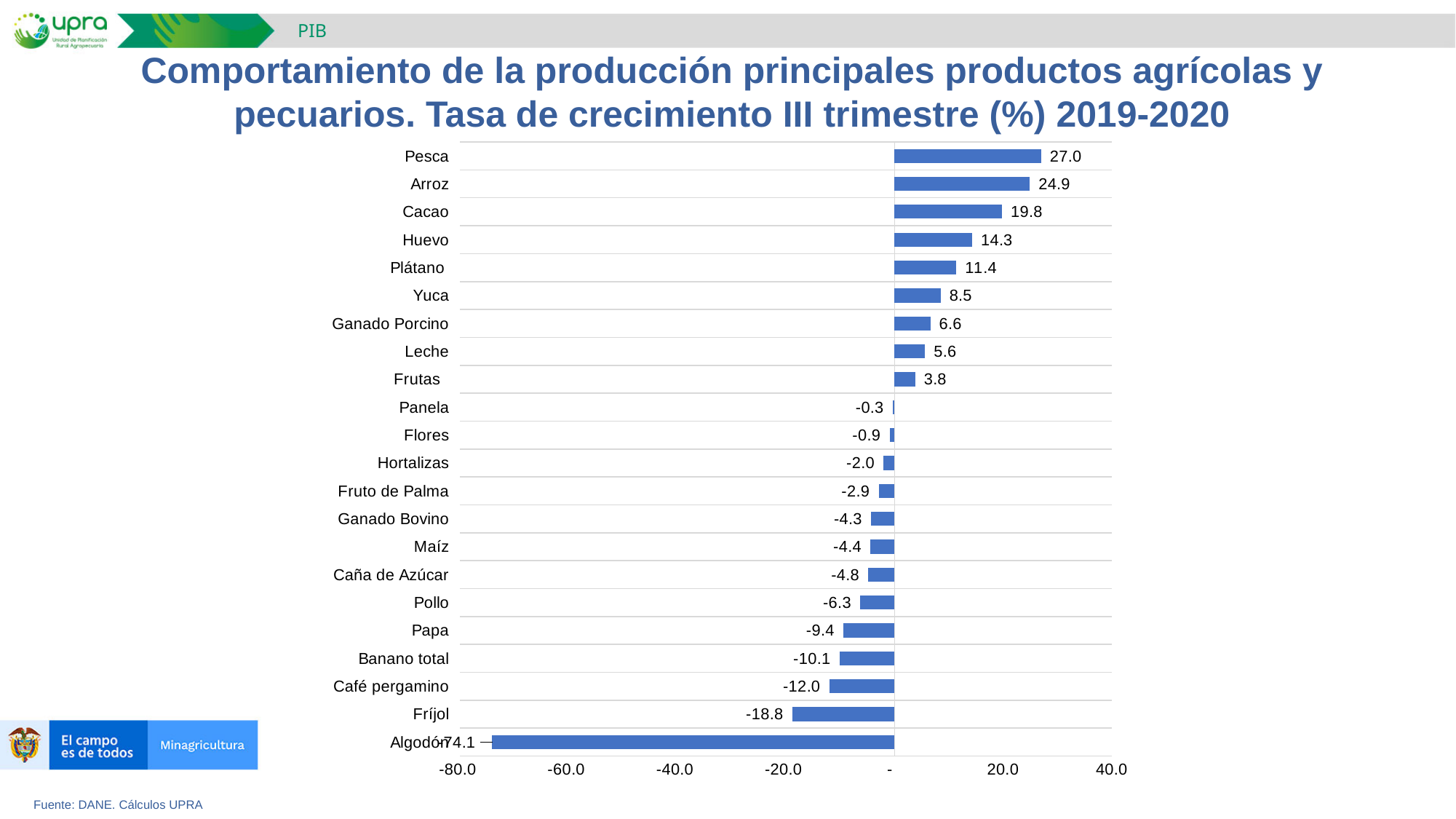
What is the growth rate value for Papa? -9.4 Which has a higher growth rate, Yuca or Leche? Yuca Which product has the lowest growth rate? Algodón How many products are shown in the chart? 22 What is the difference between the values for Pesca and Arroz? 2.1 Is the value for Algodón greater or less than -60.0? less What is the growth rate value for Huevo? 14.3 What type of chart is shown on the slide? bar chart What is the growth rate value for Fríjol? -18.8 What is the growth rate value for Panela? -0.3 What is the difference between the values for Cacao and Huevo? 5.5 Which product has the highest growth rate? Pesca